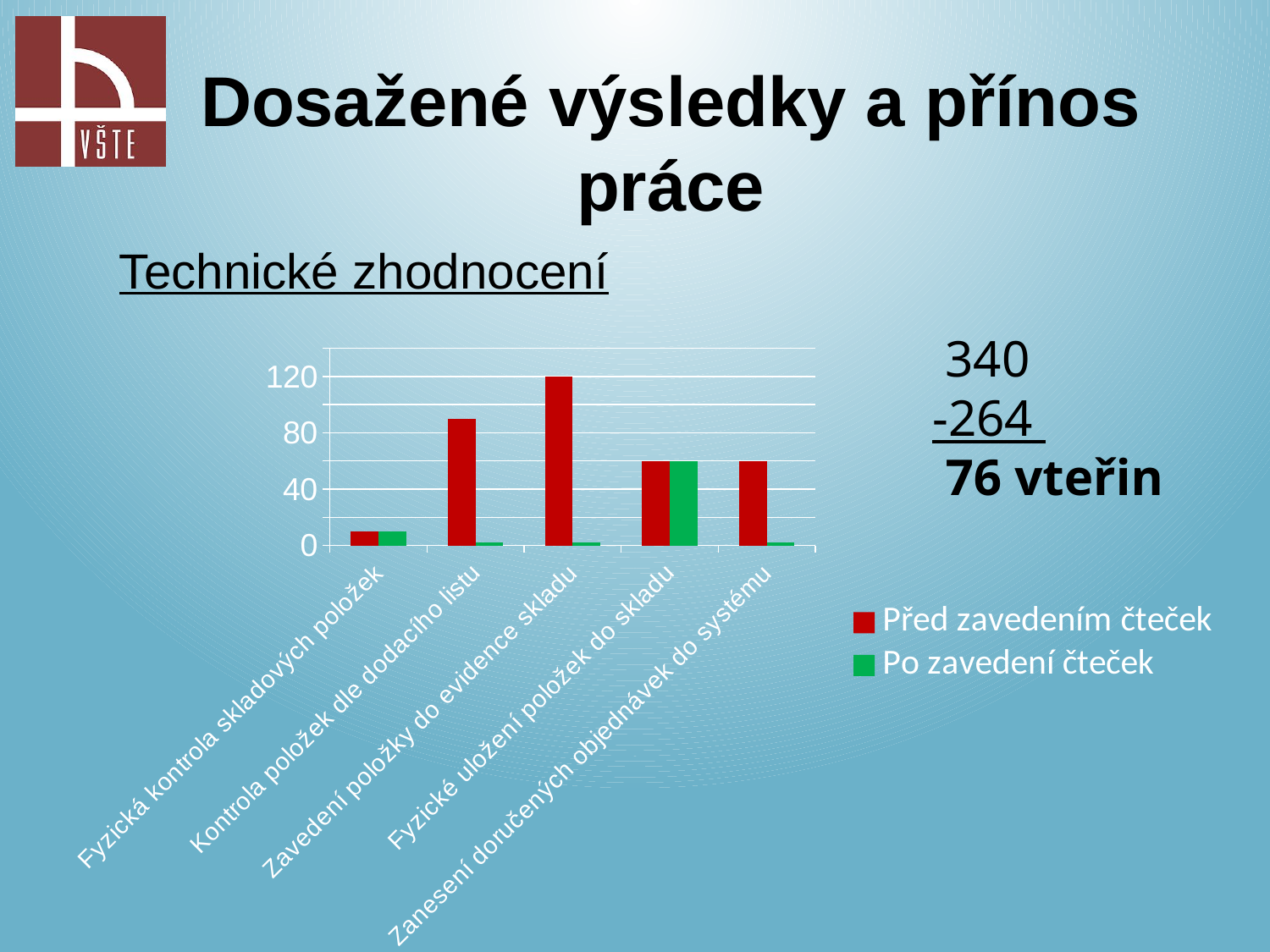
Which category has the highest value for the series "Před zavedením čteček"? Zavedení položky do evidence skladu Is the "Před zavedením čteček" value for "Kontrola položek dle dodacího listu" greater or less than 80? greater What colour represents the series "Po zavedení čteček" in the chart? green What kind of chart is shown on the slide? bar chart Is the "Před zavedením čteček" value for "Fyzická kontrola skladových položek" greater or less than 40? less What are the two series listed in the chart legend? Před zavedením čteček; Po zavedení čteček How many categories are shown on the x axis of the chart? 5 Which category has the lowest value for the series "Před zavedením čteček"? Fyzická kontrola skladových položek Is the "Před zavedením čteček" value for "Zavedení položky do evidence skladu" greater or less than 80? greater How many series does the chart legend list? 2 For the series "Před zavedením čteček", which is larger: "Kontrola položek dle dodacího listu" or "Fyzické uložení položek do skladu"? Kontrola položek dle dodacího listu For the series "Po zavedení čteček", which is larger: "Fyzické uložení položek do skladu" or "Kontrola položek dle dodacího listu"? Fyzické uložení položek do skladu